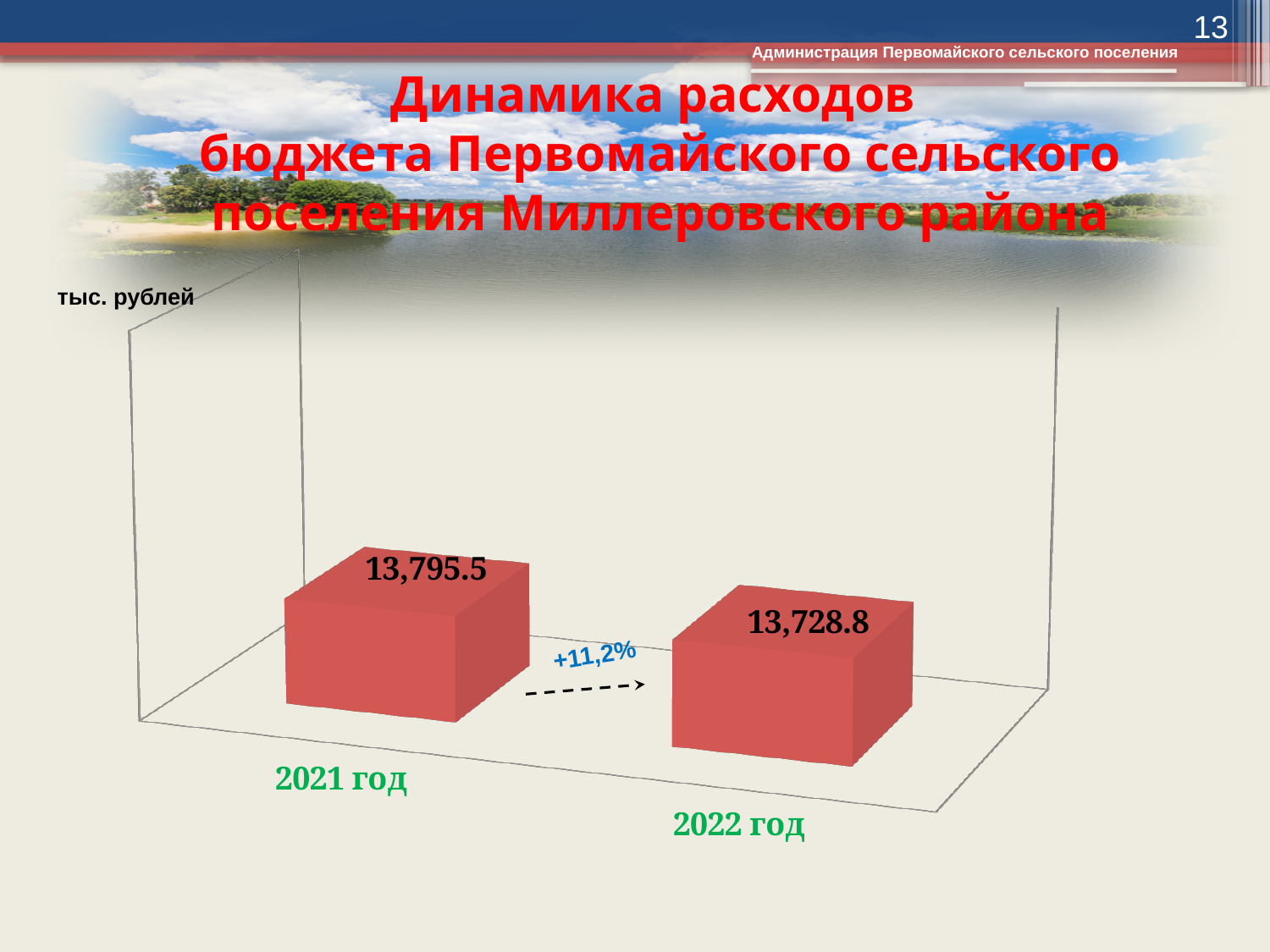
Which year has the higher value? 2021 год Is the value for 2021 год larger or smaller than the value for 2022 год? larger What is the difference between the values for 2021 год and 2022 год? 66.7 What unit of measurement is indicated for the chart? тыс. рублей What kind of chart is shown on the slide? bar chart What percentage change is printed on the arrow between the two bars? +11,2% Do the values rise or fall from 2021 год to 2022 год? fall How many bars are shown in the chart? 2 What is the value for 2021 год? 13,795.5 What is the value for 2022 год? 13,728.8 Which year has the lower value? 2022 год